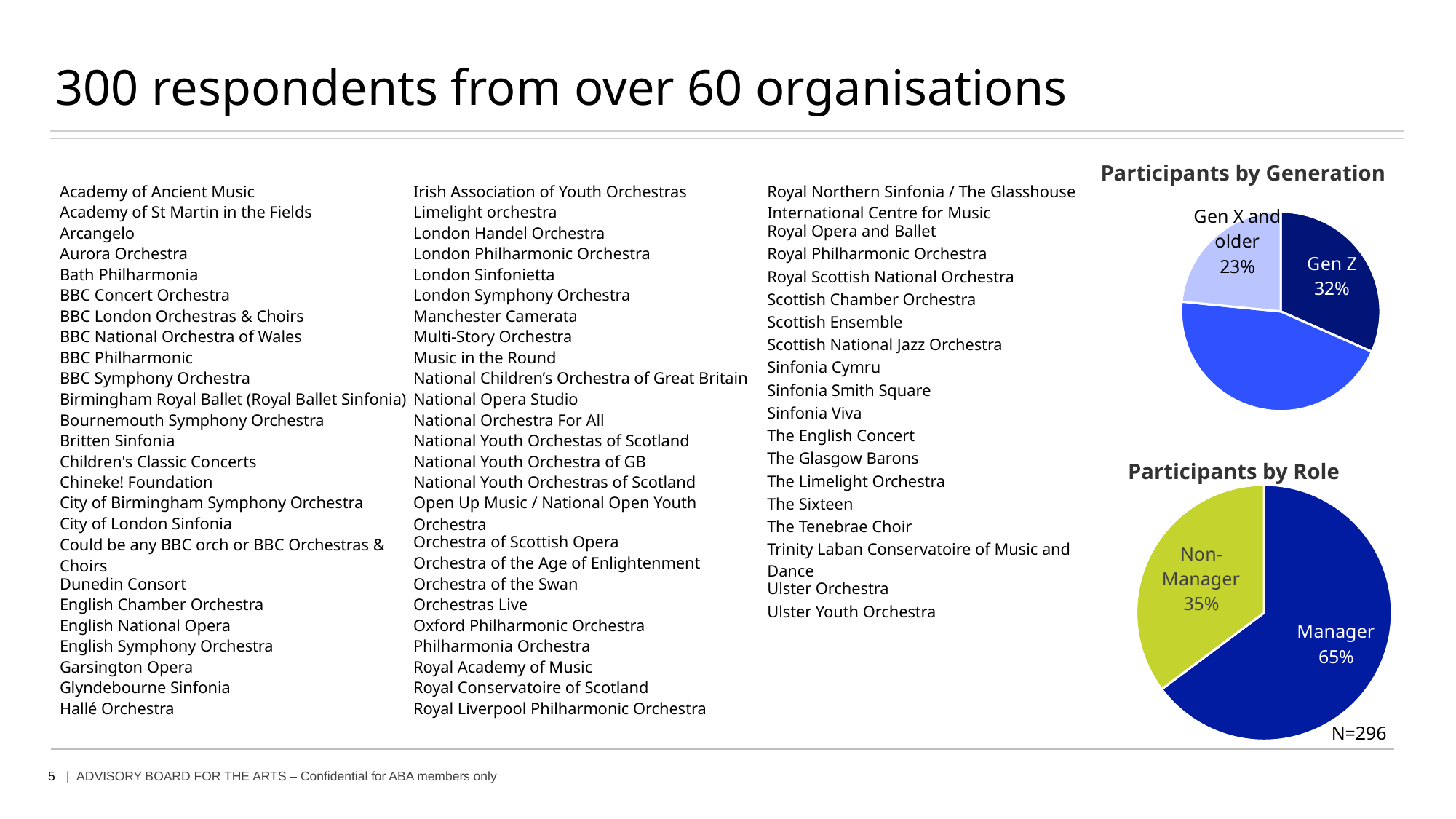
In the Participants by Generation chart, what share of participants are Gen Z? 32% In the Participants by Role chart, which role has the larger share? Manager What sample size (N) is shown beneath the Participants by Role chart? N=296 In the Participants by Generation chart, which is larger: the Gen Z share or the Gen X and older share? Gen Z In the Participants by Generation chart, what is the difference in percentage points between Gen Z and Gen X and older? 9 In the Participants by Generation chart, what share of participants are Gen X and older? 23% How many slices does the Participants by Role chart have? 2 In the Participants by Role chart, which role has the smaller share? Non-Manager In the Participants by Role chart, what is the difference in percentage points between Manager and Non-Manager? 30 In the Participants by Role chart, what percentage of participants are Managers? 65% What type of chart is Participants by Role? Pie chart In the Participants by Role chart, what percentage of participants are Non-Managers? 35%